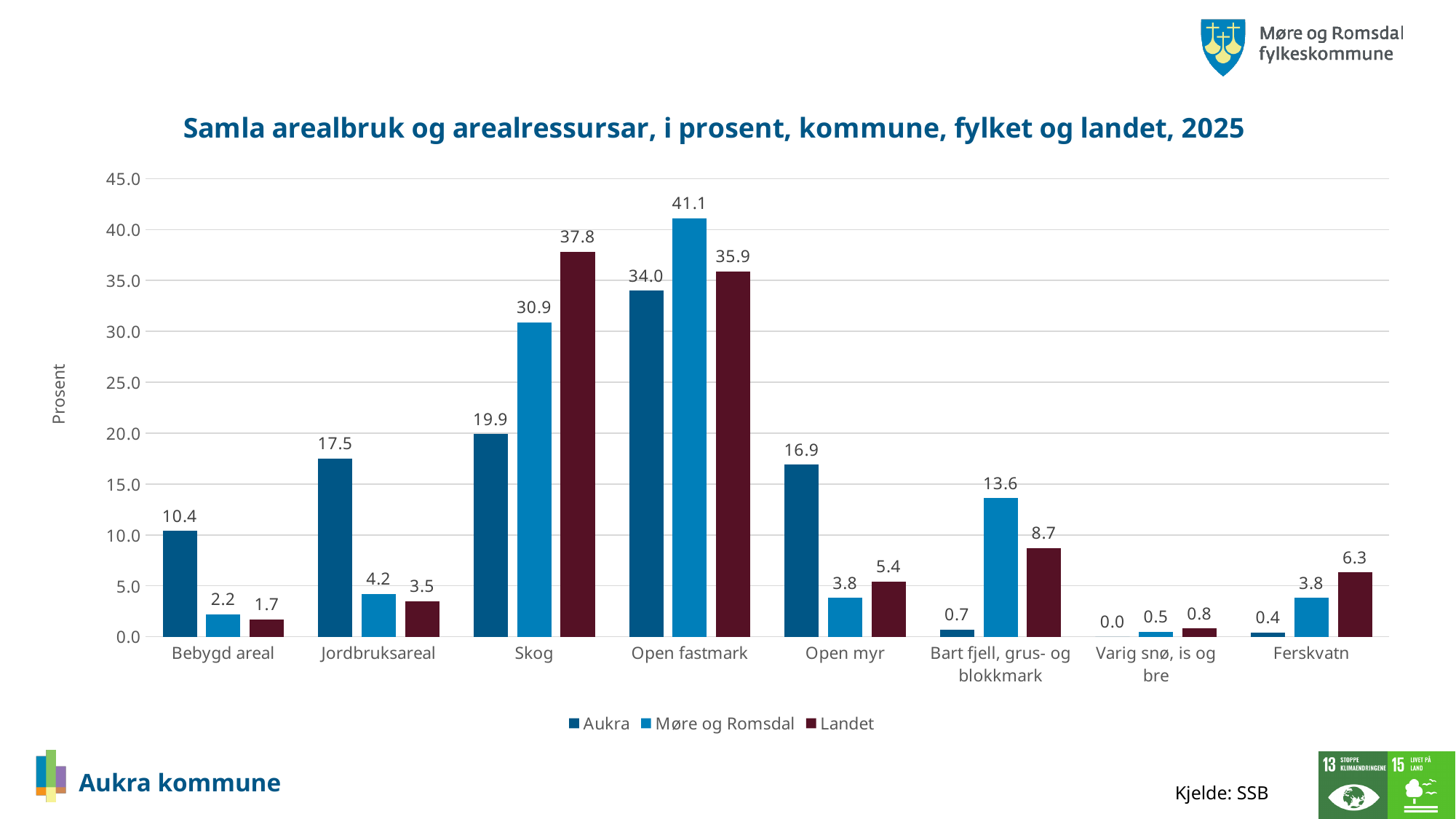
Which is larger for Open myr: the value for Aukra or the value for Landet? Aukra What is the value for Landet in the Open fastmark category? 35.9 Which category has the highest value for Møre og Romsdal? Open fastmark What kind of chart is shown on the slide? bar chart Which category has the lowest value for Aukra? Varig snø, is og bre Is the value for Møre og Romsdal in Open fastmark greater or less than 40.0? greater What is the value for Møre og Romsdal in the Bart fjell, grus- og blokkmark category? 13.6 How many series does the legend list? 3 What is the value for Aukra in the Skog category? 19.9 What is the title of the chart? Samla arealbruk og arealressursar, i prosent, kommune, fylket og landet, 2025 What is the difference between the Landet and Aukra values for Skog? 17.9 How many categories are shown on the x axis? 8